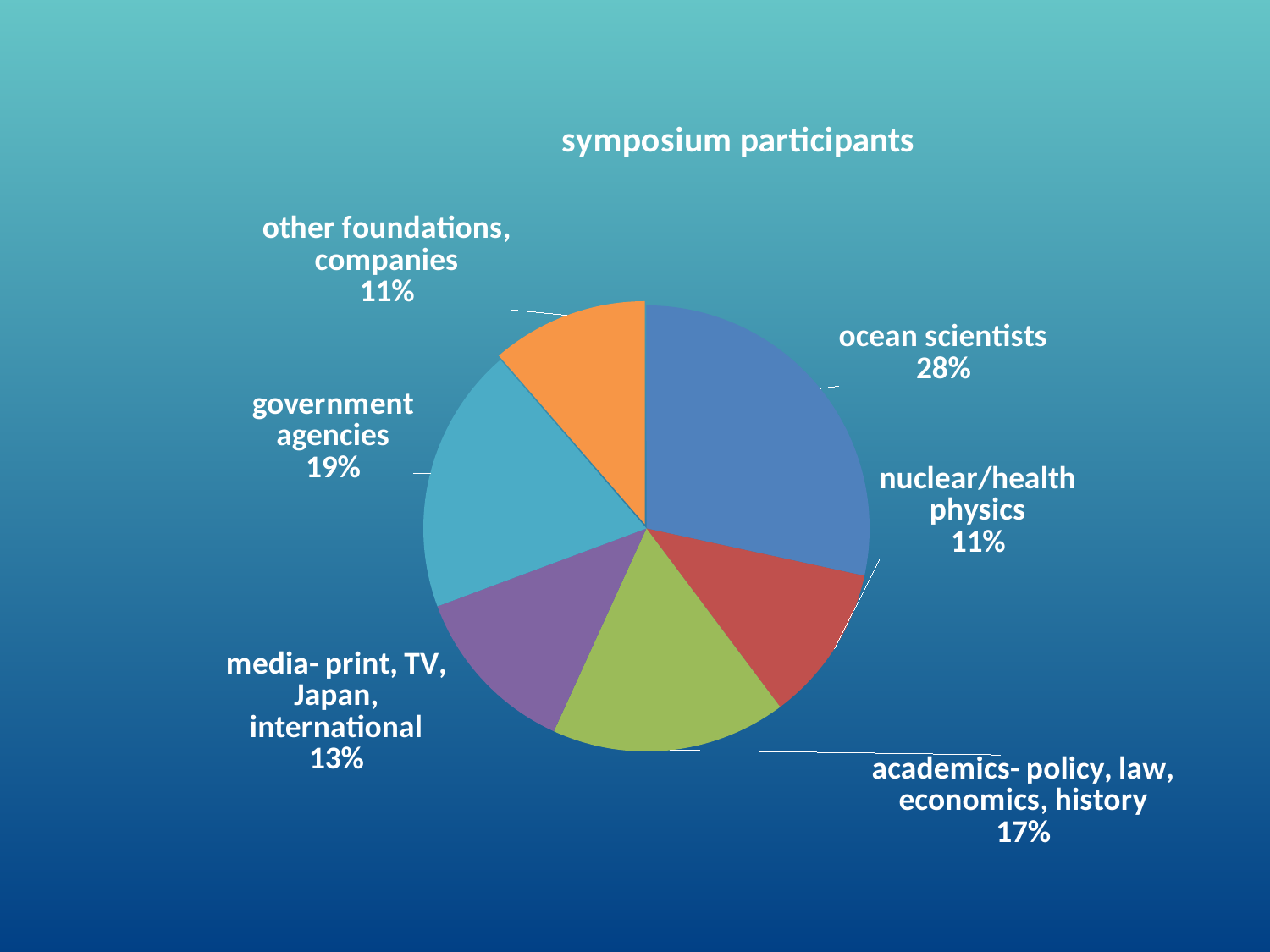
What share of symposium participants are academics in policy, law, economics, history? 17% What share of symposium participants are ocean scientists? 28% What is the difference in percentage points between ocean scientists and government agencies? 9 What kind of chart is shown on the slide? pie chart What is the title of the chart? symposium participants How many categories does the pie chart show? 6 Which category has the largest share of symposium participants? ocean scientists What share of symposium participants are from government agencies? 19% Which is larger, the share for government agencies or the share for media? government agencies What colour is the slice for ocean scientists? blue